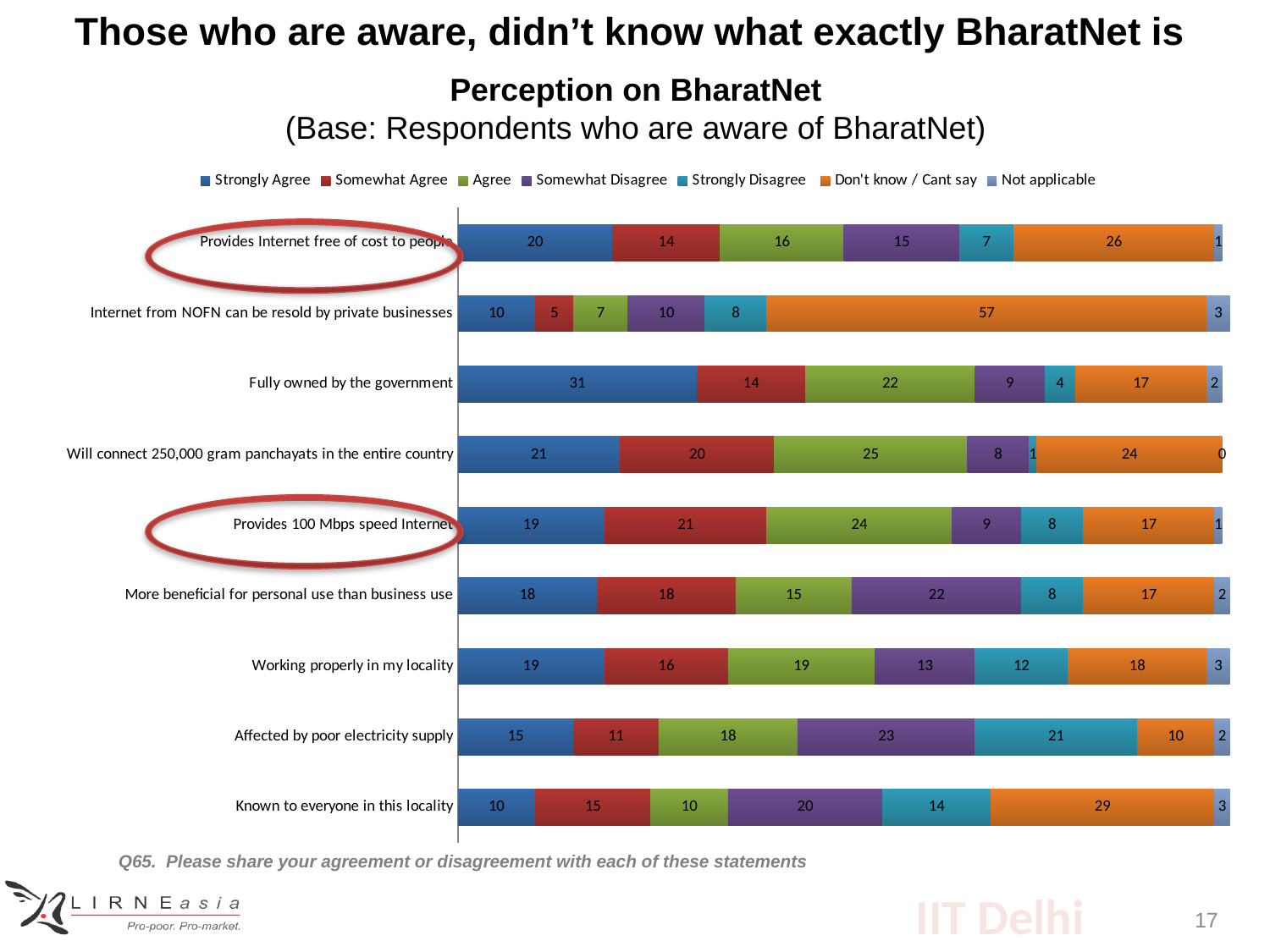
Which series is shown in orange in the legend? Don't know / Cant say How many statements (categories) are plotted on the chart? 9 What kind of chart is shown on the slide? Stacked bar chart How many series does the legend list? 7 Which statement has the highest Strongly Agree value? Fully owned by the government What is the Don't know / Cant say value for 'Internet from NOFN can be resold by private businesses'? 57 Which is larger: the Agree value for 'Will connect 250,000 gram panchayats in the entire country' or the Agree value for 'Known to everyone in this locality'? Will connect 250,000 gram panchayats in the entire country What is the difference between the Don't know / Cant say values for 'Internet from NOFN can be resold by private businesses' and 'Provides Internet free of cost to people'? 31 Which statement has the lowest Don't know / Cant say value? Affected by poor electricity supply What is the Strongly Disagree value for 'Affected by poor electricity supply'? 21 What is the Strongly Agree value for 'Fully owned by the government'? 31 What is the total of the stacked bar for 'Working properly in my locality'? 100